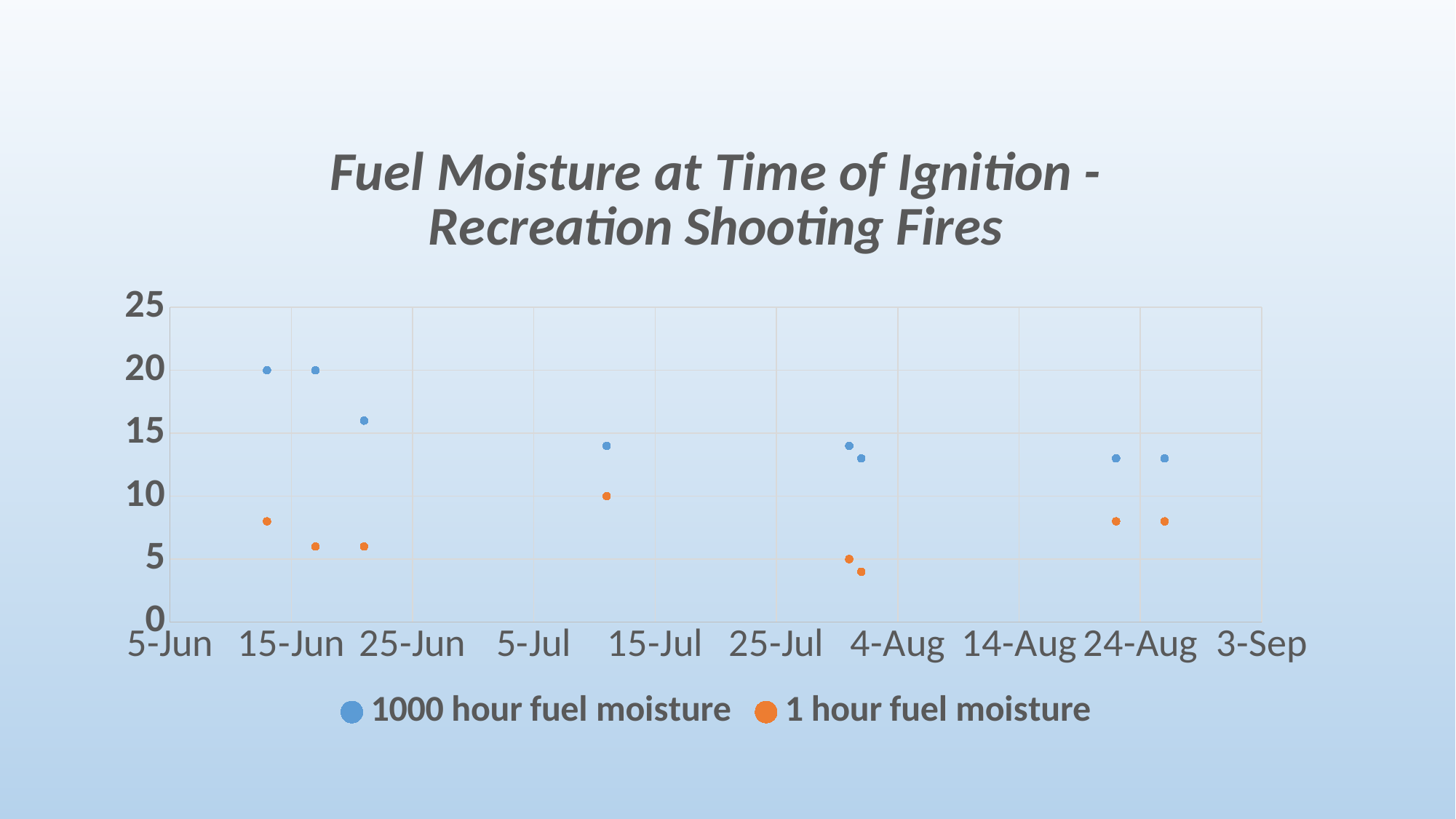
How many series does the legend list? 2 What is the title of the chart? Fuel Moisture at Time of Ignition - Recreation Shooting Fires Is the lowest 1 hour fuel moisture value greater or less than 5? less What is the highest value plotted for 1000 hour fuel moisture? 20 What kind of chart is shown on the slide? scatter chart Is the lowest 1000 hour fuel moisture value greater or less than 10? greater Which series has the higher values overall, 1000 hour fuel moisture or 1 hour fuel moisture? 1000 hour fuel moisture How many 1 hour fuel moisture points are plotted? 8 Which colour represents the 1 hour fuel moisture series? orange Do the 1000 hour fuel moisture values generally rise or fall from June to August? fall What is the highest value plotted for 1 hour fuel moisture? 10 How many 1000 hour fuel moisture points are plotted? 8